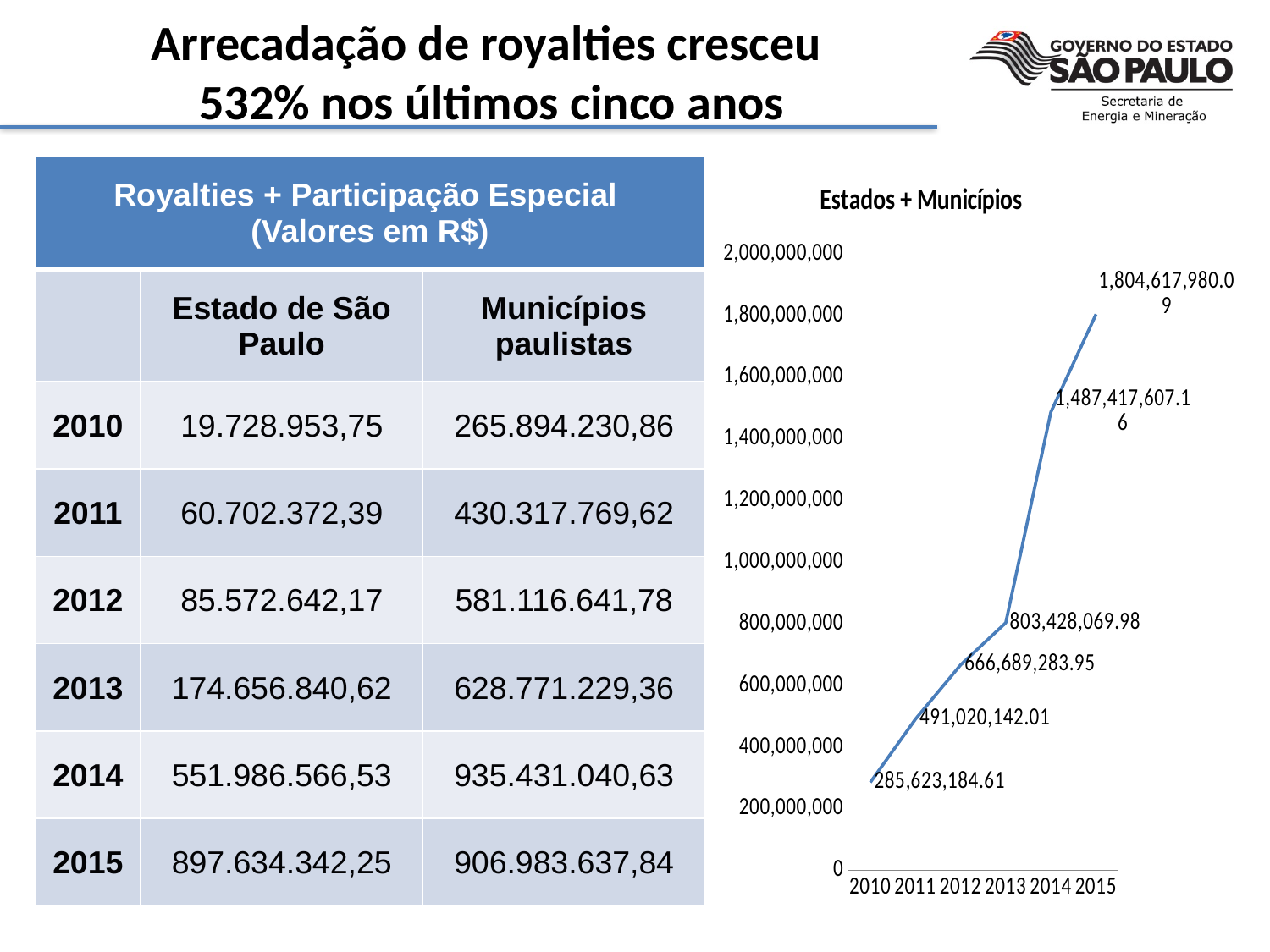
What is the value plotted for 2013 in the 'Estados + Municípios' chart? 803,428,069.98 Do the values in the 'Estados + Municípios' chart rise or fall from 2010 to 2015? rise In the 'Estados + Municípios' chart, is the value for 2014 greater or less than 1,400,000,000? greater How many years are plotted in the 'Estados + Municípios' chart? 6 What is the value plotted for 2012 in the 'Estados + Municípios' chart? 666,689,283.95 In the 'Estados + Municípios' chart, what is the difference between the 2011 and 2010 values? 205,396,957.40 What type of chart is the 'Estados + Municípios' chart? line chart What is the value plotted for 2010 in the 'Estados + Municípios' chart? 285,623,184.61 Which year has the highest value in the 'Estados + Municípios' chart? 2015 What is the value plotted for 2015 in the 'Estados + Municípios' chart? 1,804,617,980.09 In the 'Estados + Municípios' chart, what is the difference between the 2015 and 2014 values? 317,200,372.93 Which year has the lowest value in the 'Estados + Municípios' chart? 2010